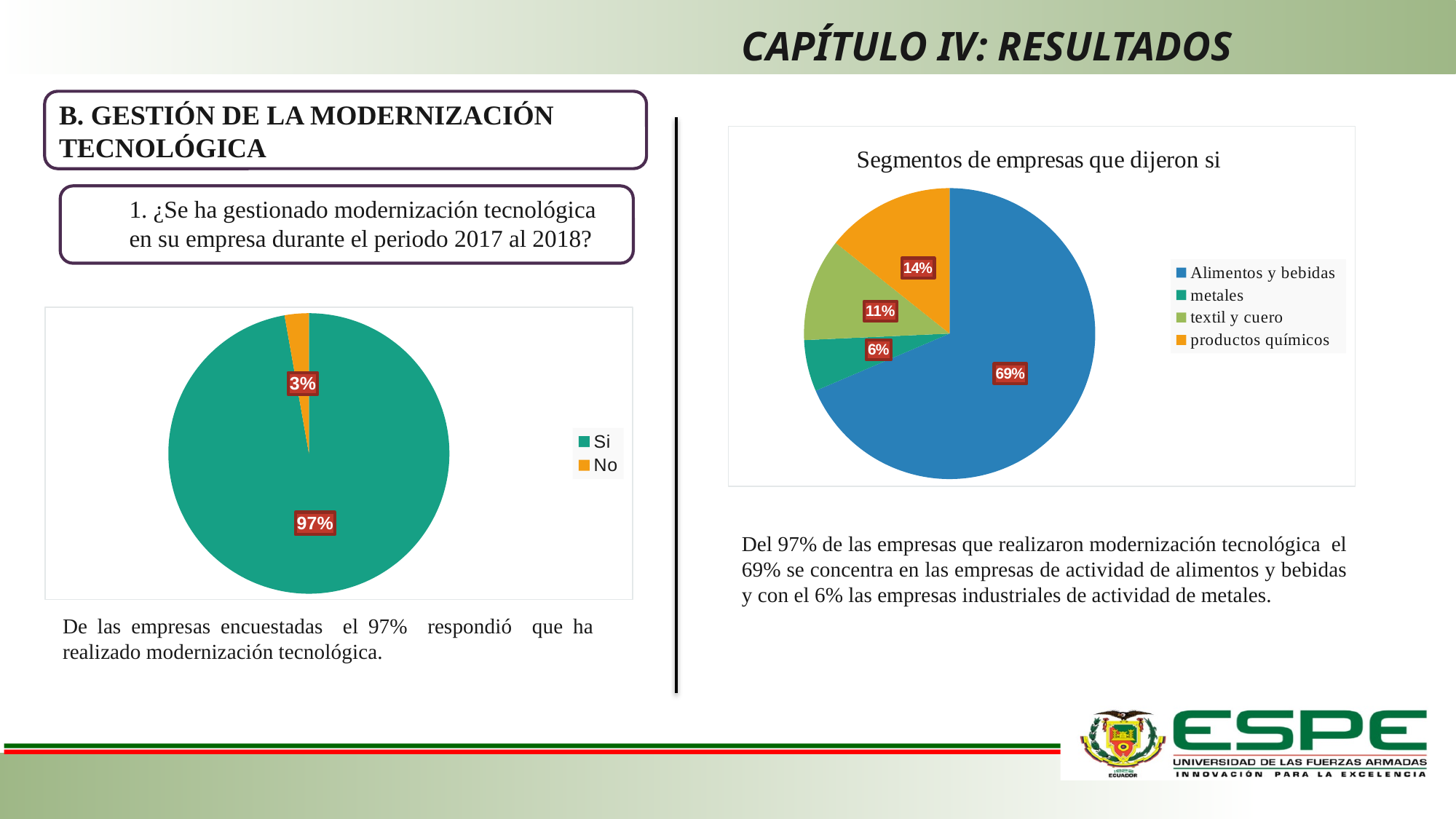
In the chart titled 'Segmentos de empresas que dijeron si', what is the share for 'metales'? 6% In the pie chart on the left, what percentage of companies answered 'No'? 3% In the chart titled 'Segmentos de empresas que dijeron si', which segment has the largest share? Alimentos y bebidas What kind of chart is shown on the left side of the slide? Pie chart In the chart titled 'Segmentos de empresas que dijeron si', what is the share for 'Alimentos y bebidas'? 69% In the chart titled 'Segmentos de empresas que dijeron si', how many segments does the legend list? 4 In the chart titled 'Segmentos de empresas que dijeron si', which is larger: 'textil y cuero' or 'productos químicos'? productos químicos In the chart titled 'Segmentos de empresas que dijeron si', which segment has the smallest share? metales In the pie chart on the left, what is the difference between the 'Si' and 'No' shares? 94% In the chart titled 'Segmentos de empresas que dijeron si', what is the share for 'productos químicos'? 14% In the pie chart on the left, how many categories does the legend list? 2 In the pie chart on the left, what percentage of companies answered 'Si'? 97%